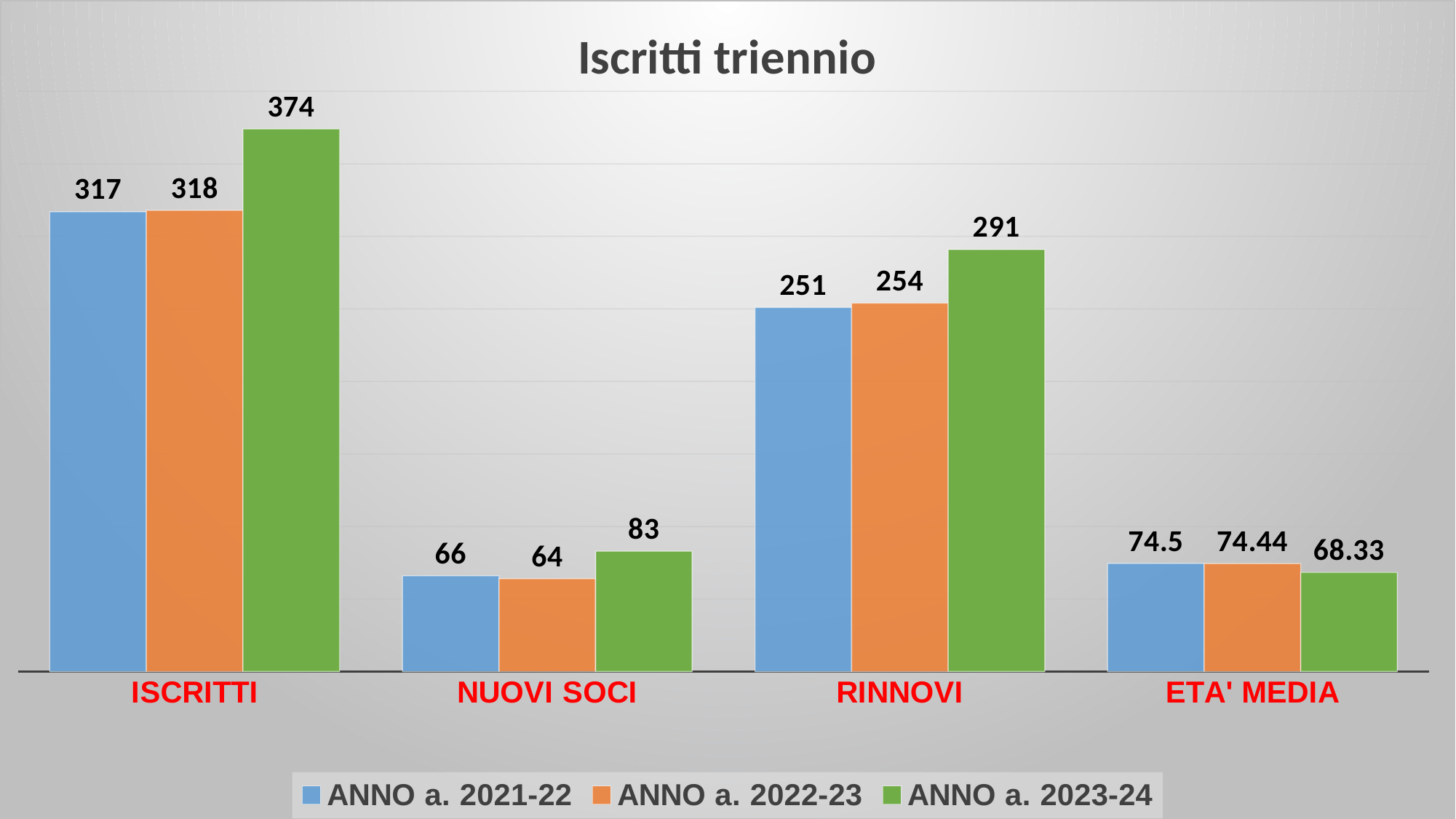
What is the value for RINNOVI in the ANNO a. 2023-24 series? 291 How many series does the legend list? 3 For NUOVI SOCI, which is larger: the ANNO a. 2021-22 value or the ANNO a. 2023-24 value? ANNO a. 2023-24 What is the value for NUOVI SOCI in the ANNO a. 2022-23 series? 64 What is the value for ETA' MEDIA in the ANNO a. 2021-22 series? 74.5 What kind of chart is shown on the slide? Bar chart What is the difference between the ANNO a. 2023-24 and ANNO a. 2022-23 values for RINNOVI? 37 Which category has the lowest value in the ANNO a. 2021-22 series? NUOVI SOCI What is the value for ISCRITTI in the ANNO a. 2023-24 series? 374 What is the difference between the ANNO a. 2023-24 and ANNO a. 2021-22 values for ISCRITTI? 57 How many categories are shown on the x axis? 4 Which category has the highest value in the ANNO a. 2023-24 series? ISCRITTI